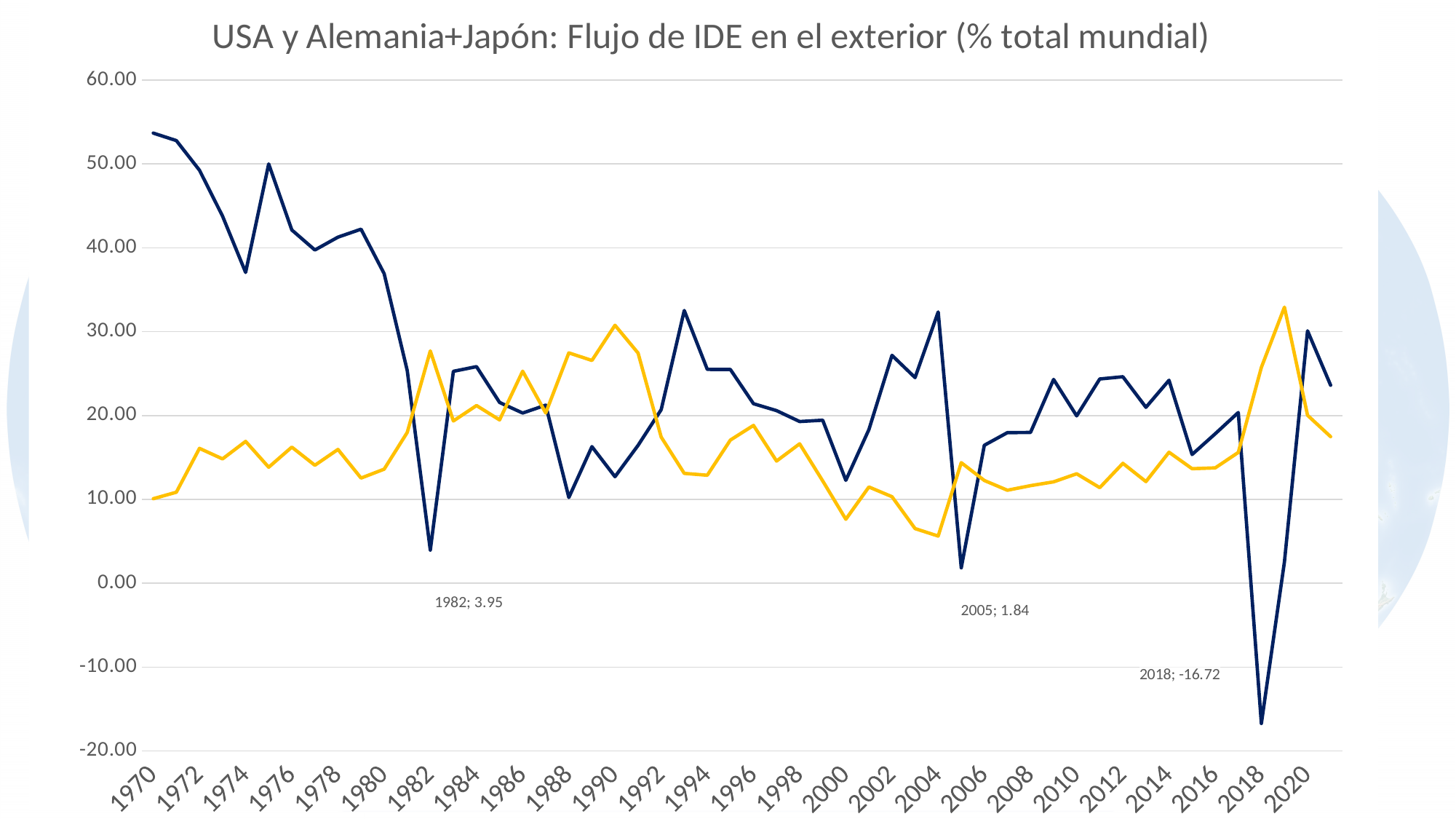
What value does the dark blue line show for 2018? -16.72 What is the title of the chart? USA y Alemania+Japón: Flujo de IDE en el exterior (% total mundial) What value does the dark blue line show for 2005? 1.84 In which year does the dark blue line reach its lowest value? 2018 Does the dark blue line rise or fall overall between 1970 and 1974? Fall What is the difference between the dark blue line's labelled values for 1982 and 2005? 2.11 What kind of chart is shown on the slide? Line chart How many lines are plotted on the chart? 2 In 2018, which line is higher, the dark blue line or the yellow line? The yellow line Is the value of the dark blue line in 1970 greater or less than 50? greater What value does the dark blue line show for 1982? 3.95 Is the value of the yellow line in 1970 greater or less than 20? less